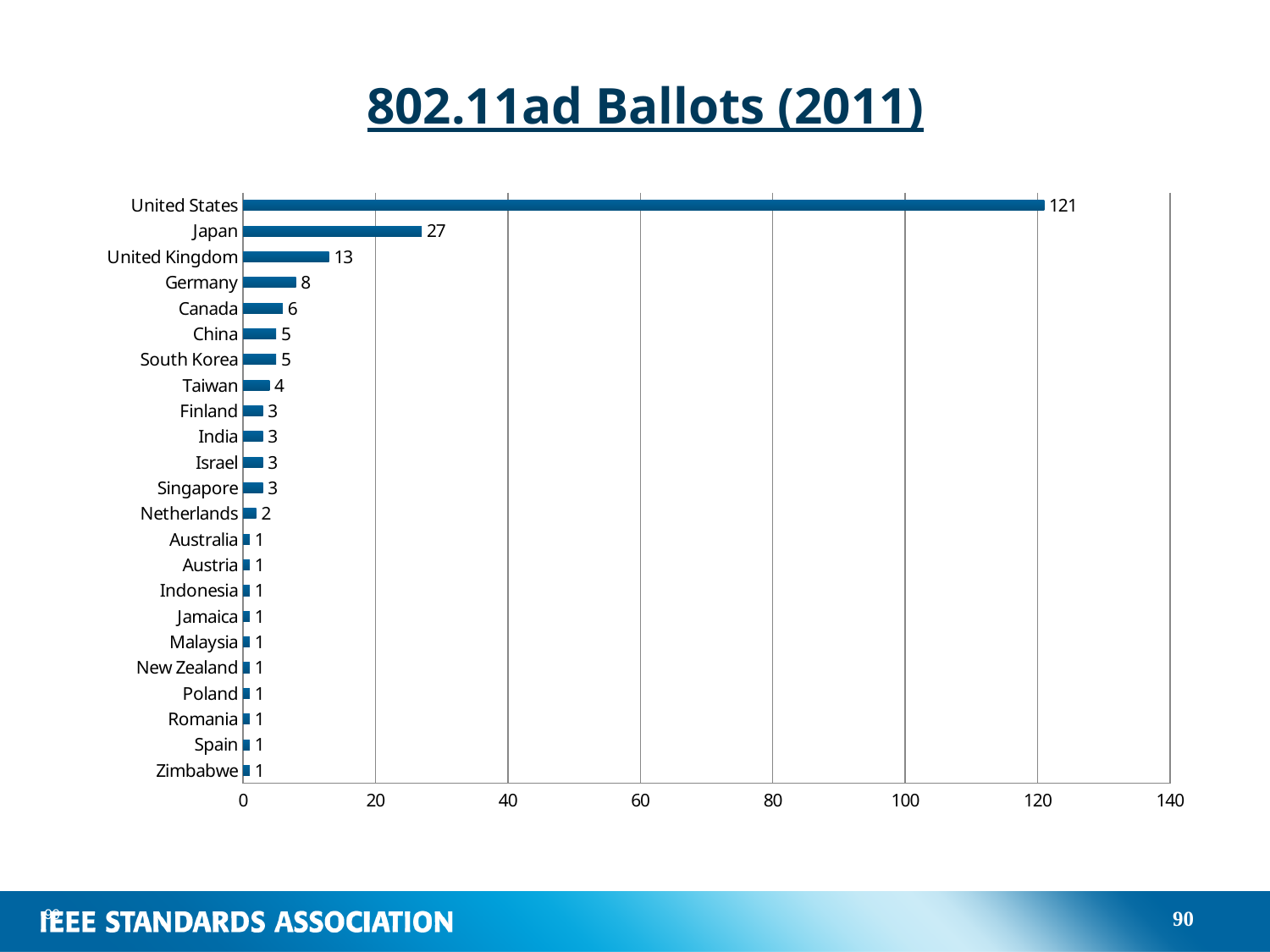
What is the difference between the values for Canada and Taiwan? 2 Is the value for United States greater or less than 100? greater What kind of chart is shown on the slide? bar chart Which country has the highest value? United States What is the value for Japan? 27 What is the value for Germany? 8 How many countries are shown on the chart? 23 What is the value for Netherlands? 2 What is the value for the United Kingdom? 13 What is the title of the chart? 802.11ad Ballots (2011) What is the difference between the values for United States and Japan? 94 Which is larger, the value for Germany or the value for Canada? Germany